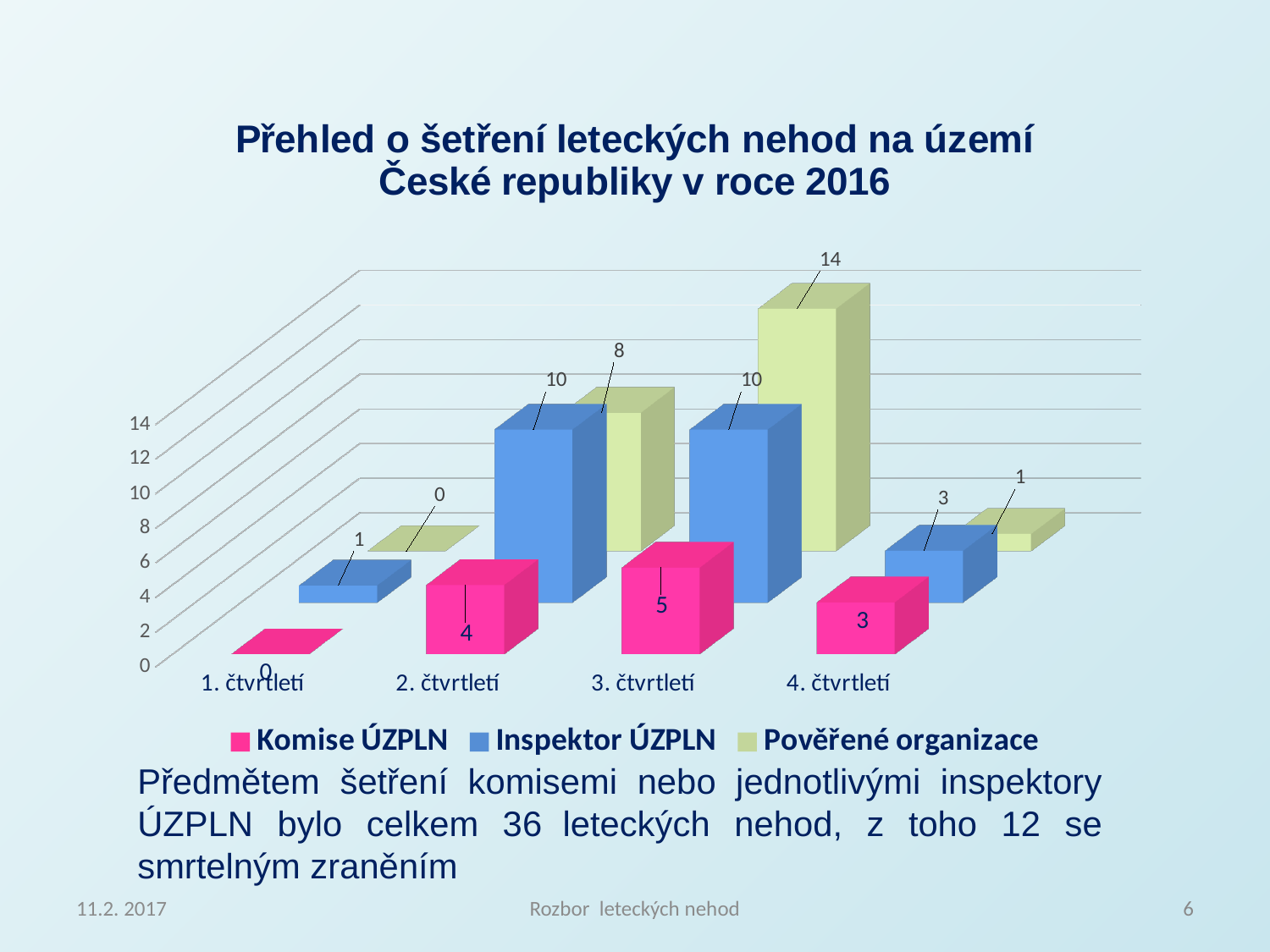
How many quarters (categories) are shown on the x axis? 4 In which quarter does Komise ÚZPLN have its lowest value? 1. čtvrtletí In which quarter does Pověřené organizace reach its highest value? 3. čtvrtletí What kind of chart is shown on the slide? Bar chart Which is larger in 2. čtvrtletí: Inspektor ÚZPLN or Pověřené organizace? Inspektor ÚZPLN What is the value for Pověřené organizace in 1. čtvrtletí? 0 How many series does the legend list? 3 Which colour represents Komise ÚZPLN in the legend? Pink What is the value for Komise ÚZPLN in 4. čtvrtletí? 3 What is the value for Pověřené organizace in 3. čtvrtletí? 14 What is the value for Inspektor ÚZPLN in 2. čtvrtletí? 10 What is the difference between Pověřené organizace and Komise ÚZPLN in 3. čtvrtletí? 9